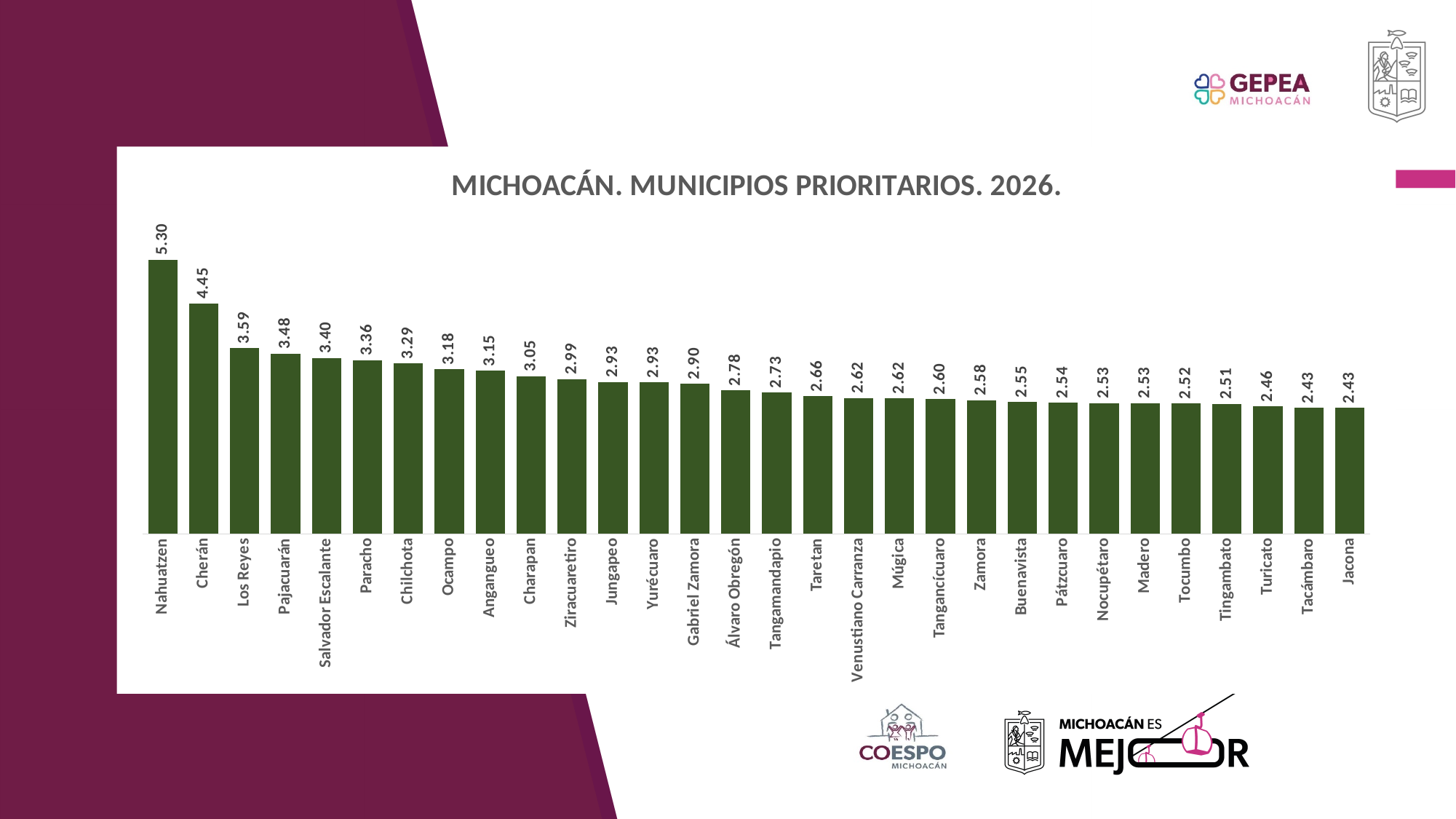
Which municipality has the highest value? Nahuatzen Which has a larger value, Taretan or Charapan? Charapan What is the value for Zamora? 2.58 How many municipalities are shown in the chart? 30 What is the value for Salvador Escalante? 3.40 Which has a larger value, Paracho or Ocampo? Paracho What is the value for Nahuatzen? 5.30 What kind of chart is shown on the slide? Bar chart What is the difference between the values for Nahuatzen and Cherán? 0.85 What is the difference between the values for Los Reyes and Jacona? 1.16 What is the title of the chart? MICHOACÁN. MUNICIPIOS PRIORITARIOS. 2026. What is the value for Pátzcuaro? 2.54